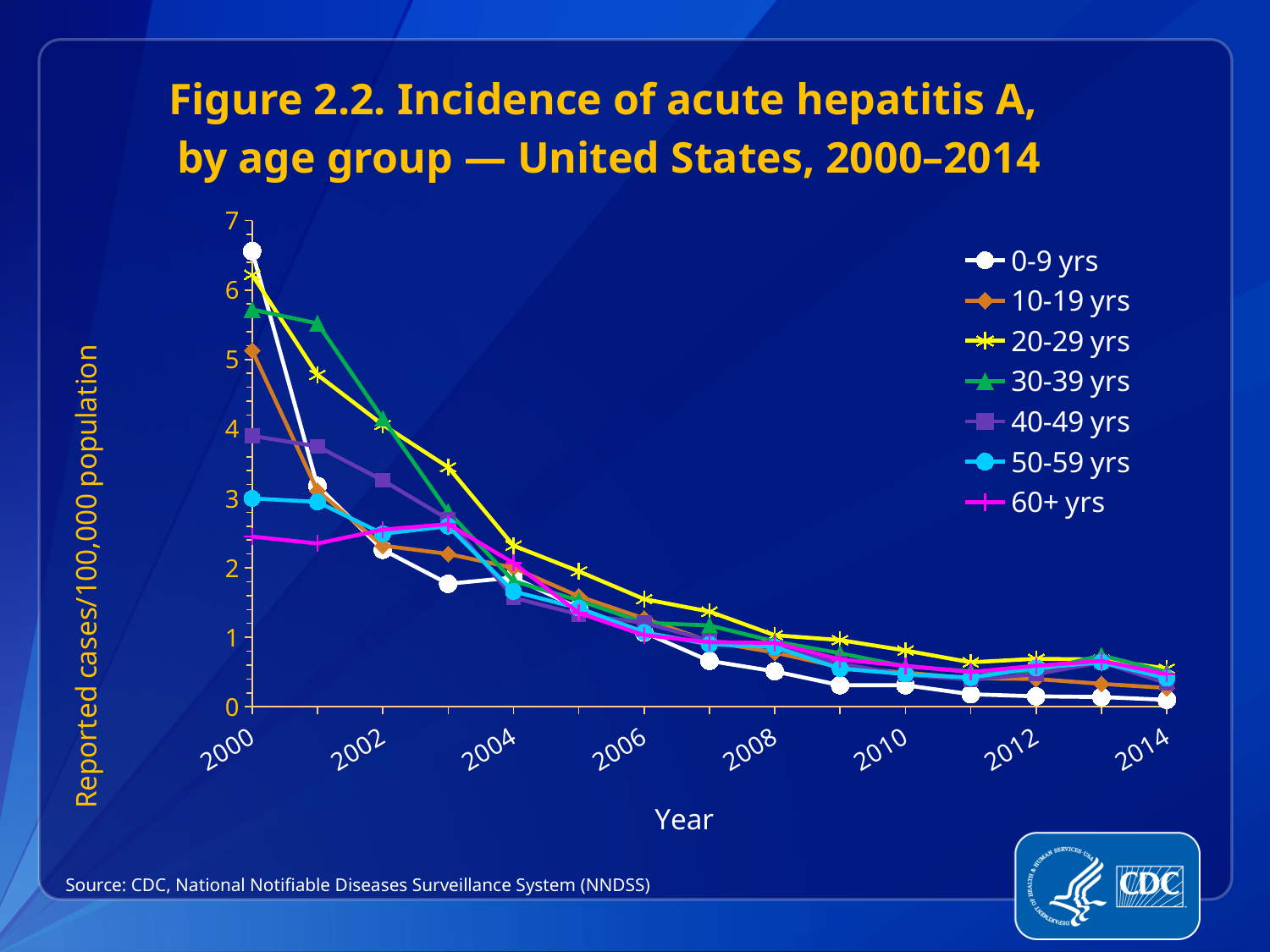
Which age group had the lowest incidence in 2000? 60+ yrs Is the value for 20-29 yrs in 2003 greater or less than 3? greater Is the value for 60+ yrs in 2000 greater or less than 3? less Is the value for 0-9 yrs in 2014 greater or less than 1? less Which age group had the highest incidence in 2000? 0-9 yrs What is the label on the y axis? Reported cases/100,000 population In 2000, which had a higher incidence: 10-19 yrs or 40-49 yrs? 10-19 yrs What kind of chart is shown on the slide? line chart Overall, does the incidence for 0-9 yrs rise or fall from 2000 to 2014? fall How many age-group series does the legend list? 7